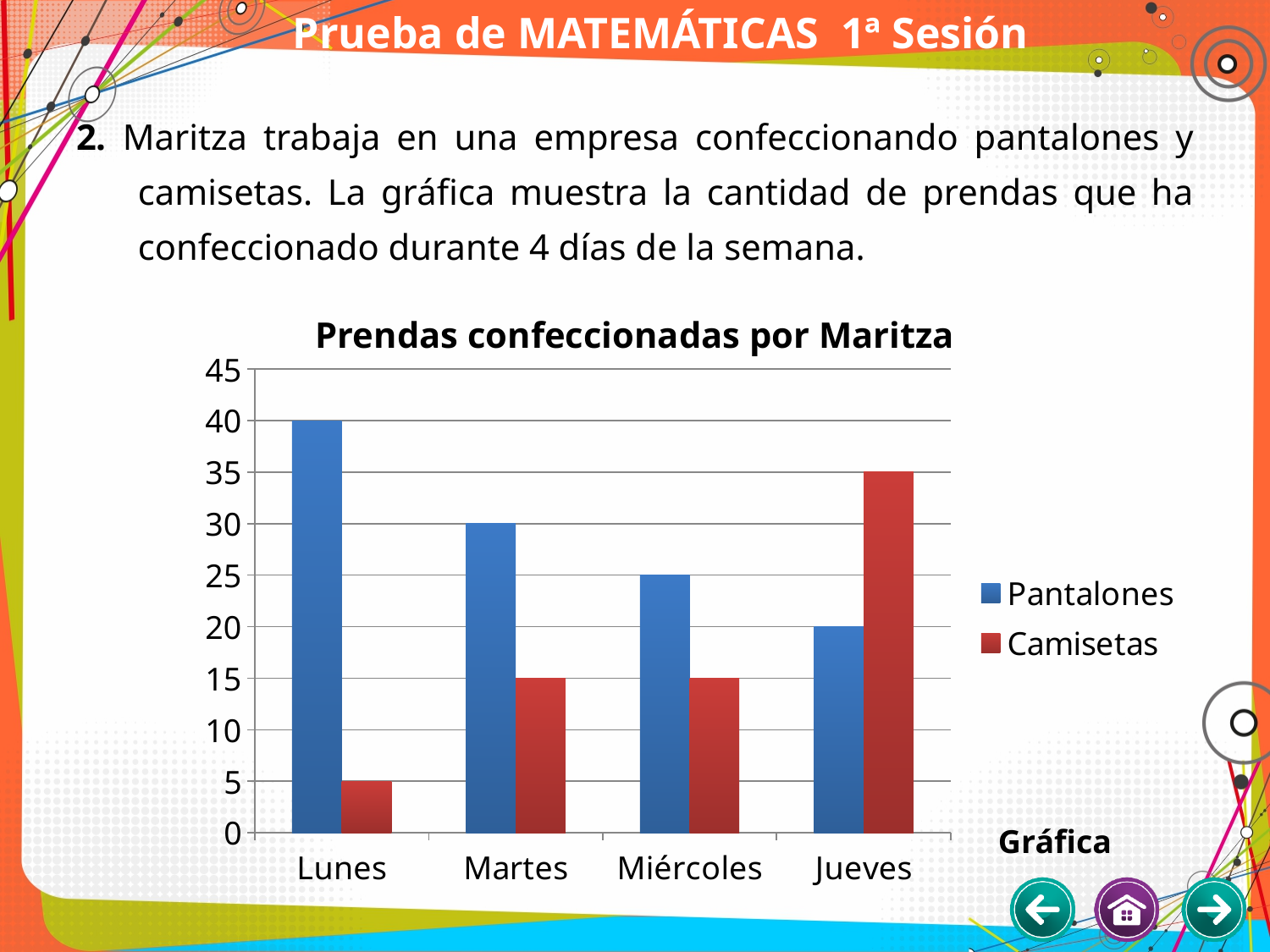
How many days (categories) are shown on the x axis? 4 On which day is the Pantalones value highest? Lunes How many Camisetas were made on Jueves? 35 How many series does the legend list? 2 Do the Pantalones values rise or fall from Lunes to Jueves? fall What is the difference between Pantalones and Camisetas on Martes? 15 On which day is the Camisetas value lowest? Lunes Which is larger on Jueves, Pantalones or Camisetas? Camisetas What type of chart is shown on the slide? bar chart How many Camisetas were made on Lunes? 5 What is the title of the chart? Prendas confeccionadas por Maritza How many Pantalones were made on Lunes? 40